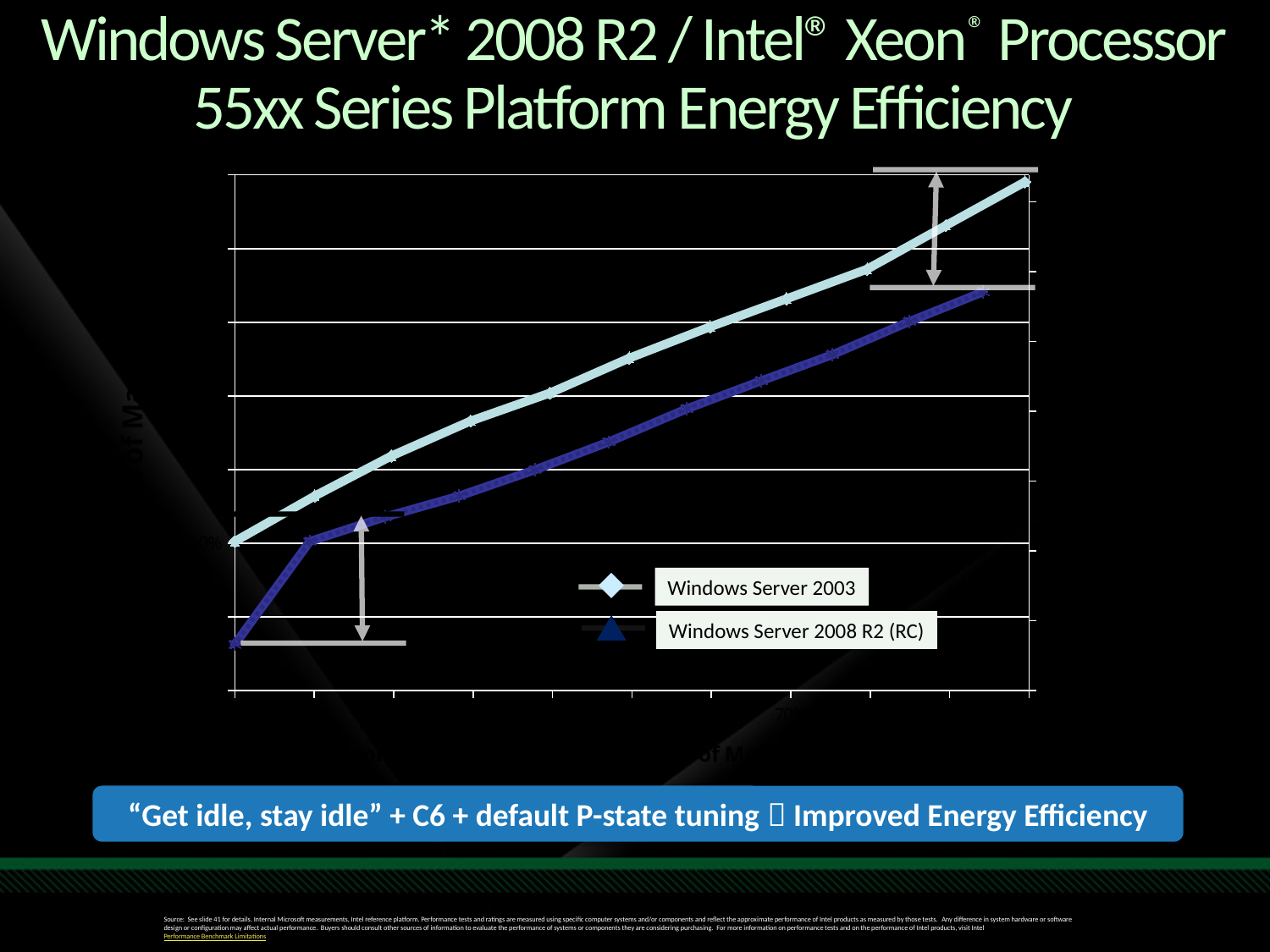
What kind of chart is shown on the slide? line chart Do the values for the Windows Server 2008 R2 (RC) series rise or fall from left to right along the x axis? rise Is the leftmost value for Windows Server 2008 R2 (RC) greater or less than 50%? less How many series does the chart's legend list? 2 Do the values for the Windows Server 2003 series rise or fall from left to right along the x axis? rise What are the two series named in the chart's legend? Windows Server 2003 and Windows Server 2008 R2 (RC) Is the rightmost value for Windows Server 2003 greater or less than 50%? greater Which series is plotted higher on the chart across the x axis, Windows Server 2003 or Windows Server 2008 R2 (RC)? Windows Server 2003 Is the rightmost value for Windows Server 2008 R2 (RC) greater or less than 50%? greater Which legend entry is drawn with a light blue line and diamond markers? Windows Server 2003